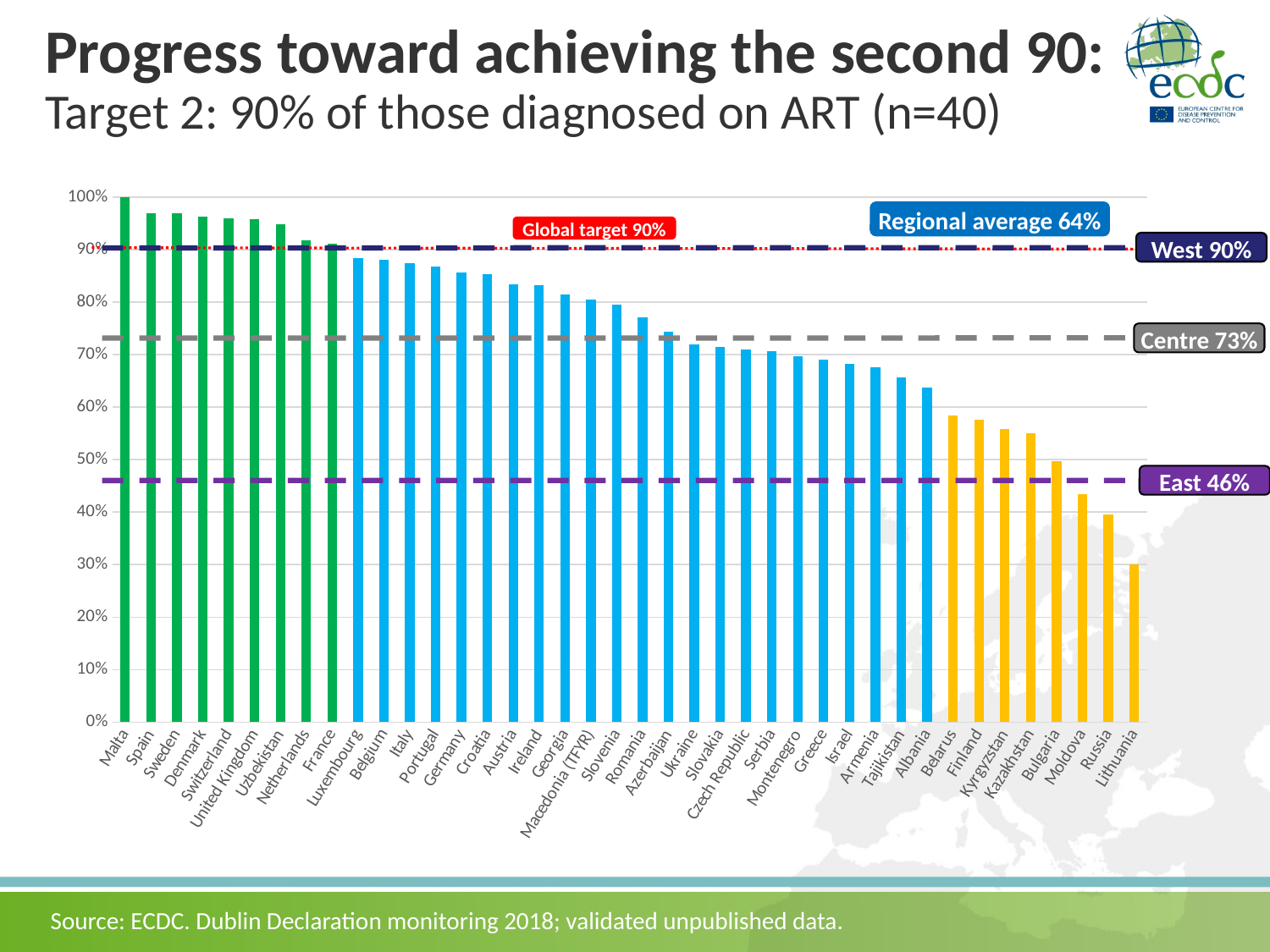
What is the regional average shown on the chart? 64% Is the value for Belarus greater or less than 60%? less Which country has the lowest value in the chart? Lithuania What value does the 'Centre' reference line represent? 73% Do the values rise or fall moving from left to right along the x axis? fall Which has a larger value, Italy or Greece? Italy Which country has the highest value in the chart? Malta What kind of chart is shown on the slide? bar chart How many countries are plotted in the chart? 40 Is the value for Spain greater or less than 90%? greater Is the value for Russia greater or less than 50%? less